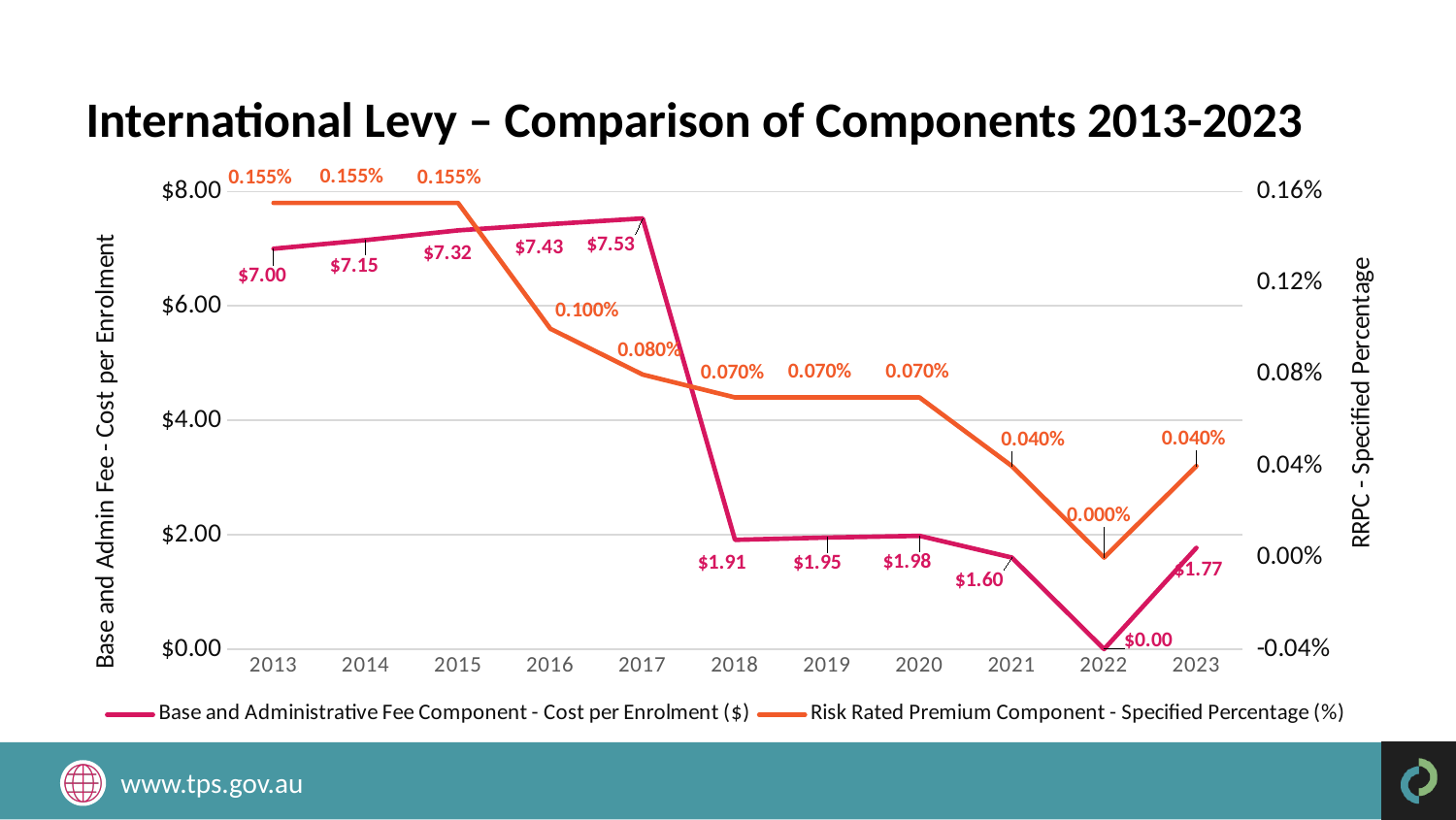
Which is larger, the Base and Administrative Fee Component cost per enrolment in 2020 or in 2023? 2020 How many years are plotted on the x axis? 11 What is the Risk Rated Premium Component specified percentage in 2016? 0.100% What is the Base and Administrative Fee Component cost per enrolment in 2017? $7.53 What is the Base and Administrative Fee Component cost per enrolment in 2021? $1.60 What is the difference between the Base and Administrative Fee Component cost per enrolment in 2017 and in 2018? $5.62 Does the Risk Rated Premium Component specified percentage rise or fall from 2013 to 2022? Fall In which year is the Base and Administrative Fee Component cost per enrolment highest? 2017 How many series does the legend list? 2 What is the title of the chart? International Levy – Comparison of Components 2013-2023 What kind of chart is shown on the slide? Line chart In which year is the Base and Administrative Fee Component cost per enrolment lowest? 2022